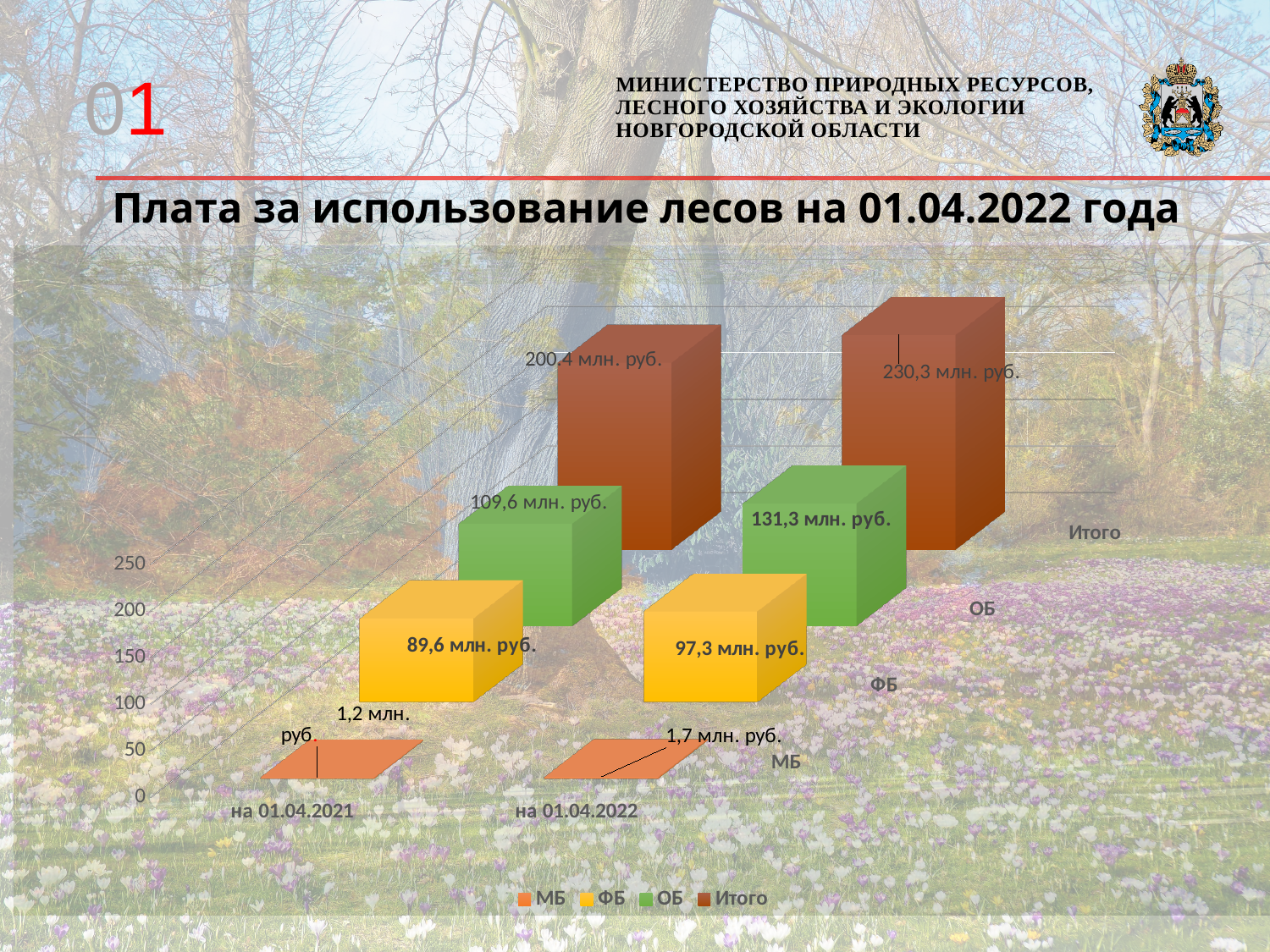
What is the difference between the Итого values for на 01.04.2022 and на 01.04.2021? 29,9 млн. руб. Which is larger: ОБ for на 01.04.2021 or ОБ for на 01.04.2022? на 01.04.2022 What is the value of ОБ for на 01.04.2022? 131,3 млн. руб. What is the value of МБ for на 01.04.2021? 1,2 млн. руб. Which series has the lowest value for на 01.04.2022? МБ What is the value of ФБ for на 01.04.2021? 89,6 млн. руб. How many series does the legend list? 4 What kind of chart is shown on the slide? Bar chart Which series has the highest value for на 01.04.2021? Итого What is the title of the chart? Плата за использование лесов на 01.04.2022 года How many categories are shown on the x axis? 2 What is the value of Итого for на 01.04.2022? 230,3 млн. руб.